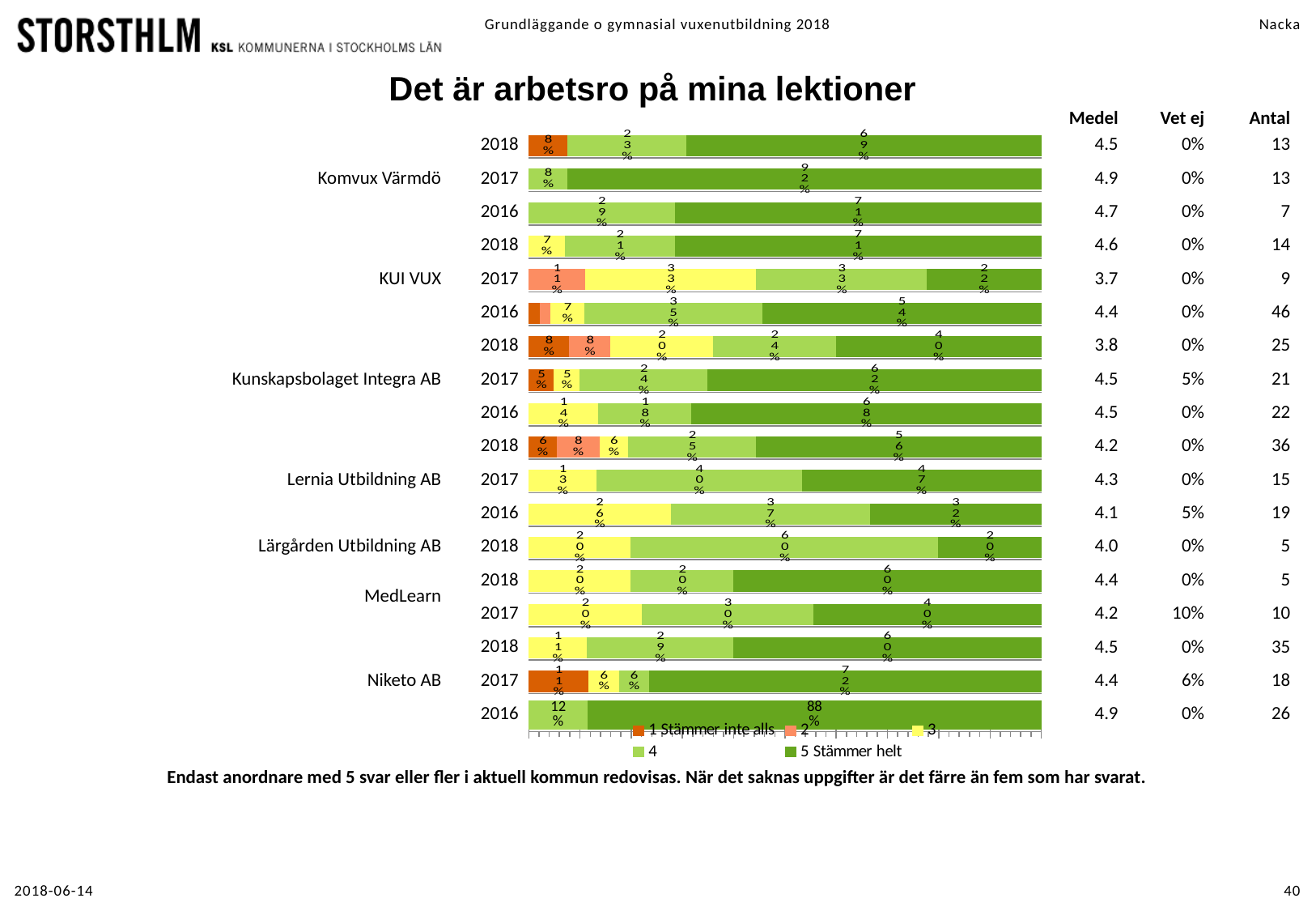
For Niketo AB in 2016, what is the difference between the '5 Stämmer helt' share and the '4' share? 76 percentage points How many bars are plotted in the chart? 18 What is the share of '5 Stämmer helt' for Niketo AB in 2016? 88% What is the share of '2' for KUI VUX in 2017? 11% For Komvux Värmdö, which year has the highest share of '5 Stämmer helt'? 2017 What is the share of '4' for Lärgården Utbildning AB in 2018? 60% How many series does the legend list? 5 For Lernia Utbildning AB in 2016, which is larger: the share of '4' or the share of '5 Stämmer helt'? 4 What is the title of the chart? Det är arbetsro på mina lektioner What kind of chart is shown on the slide? Stacked bar chart What is the share of '5 Stämmer helt' for MedLearn in 2017? 40% What is the share of '5 Stämmer helt' for Komvux Värmdö in 2017? 92%